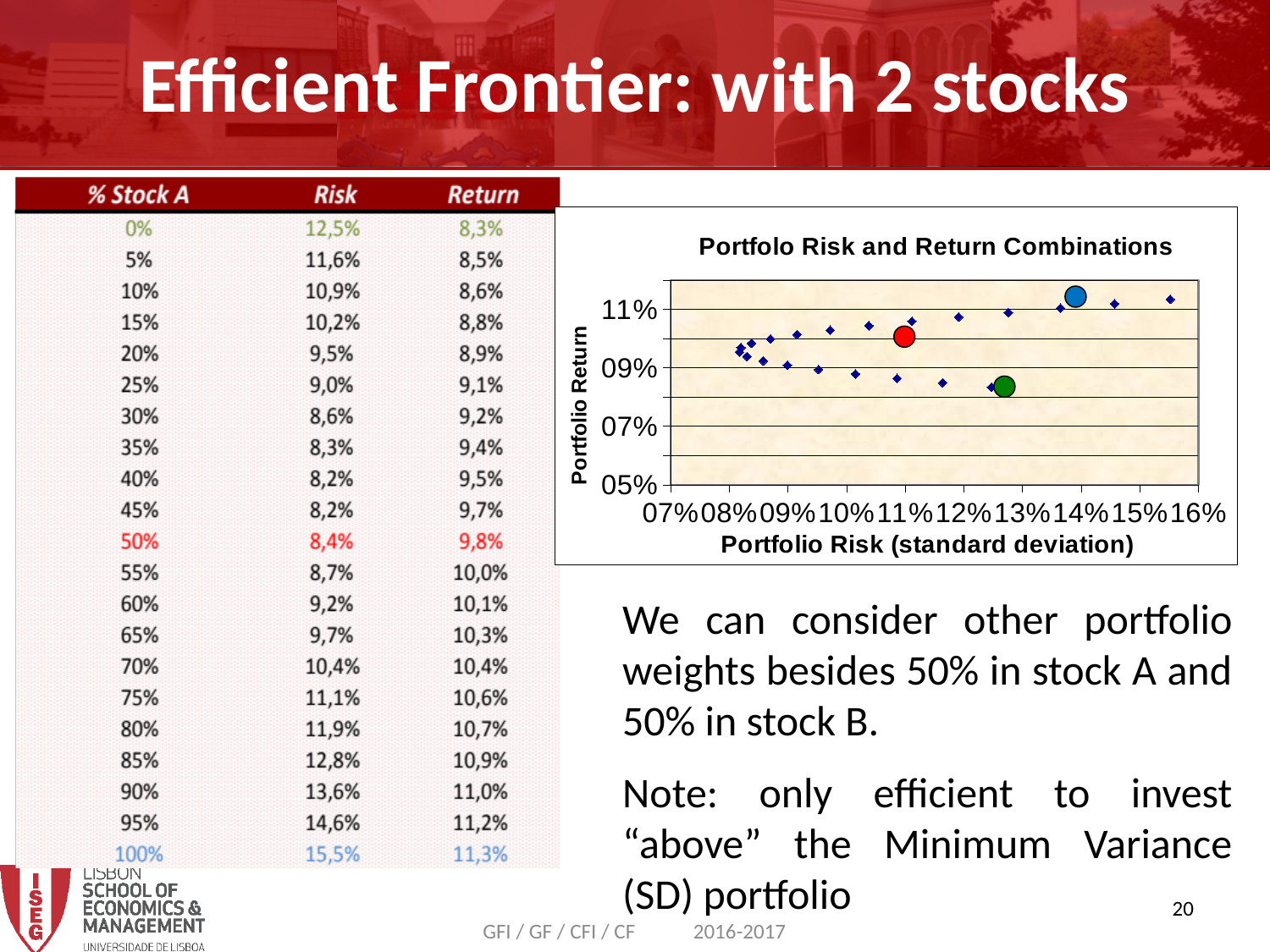
Is the portfolio risk of the large red point greater or less than 10%? greater Is the portfolio return of the large green point greater or less than 09%? less What is the title of the chart on the slide? Portfolo Risk and Return Combinations Is the portfolio return of the large red point greater or less than 09%? greater What is the label of the horizontal axis of the chart? Portfolio Risk (standard deviation) Which has the higher portfolio risk, the large red point or the large green point? the large green point Which of the three large highlighted points has the lowest portfolio risk? the red point Which has the higher portfolio return, the large blue point or the large green point? the large blue point What kind of chart is shown on the slide? scatter chart Which of the three large highlighted points has the highest portfolio return? the blue point